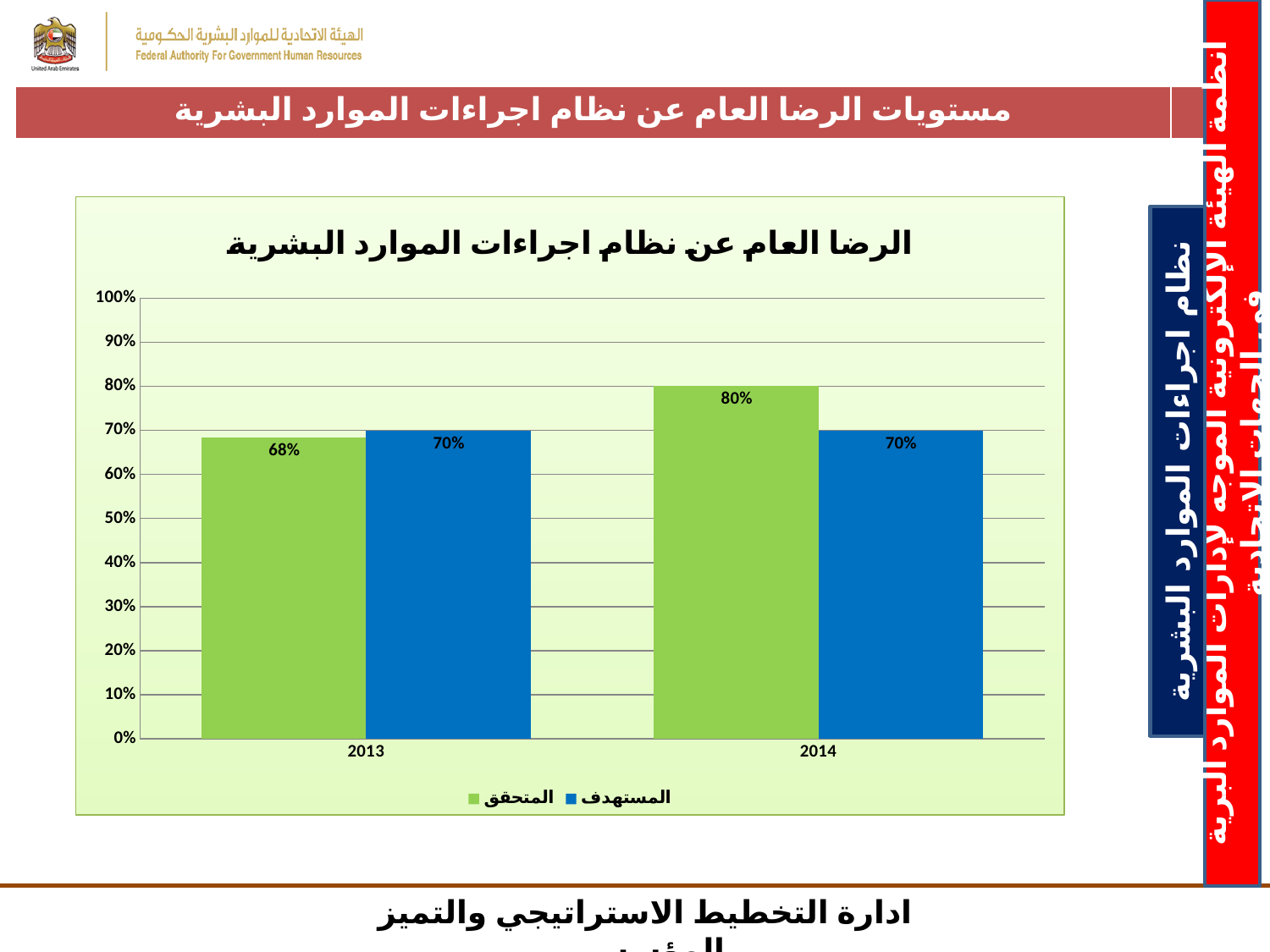
In 2013, which is larger: المتحقق (achieved) or المستهدف (target)? المستهدف (target) What is the value of المتحقق (achieved) for 2013? 68% In 2014, which is larger: المتحقق (achieved) or المستهدف (target)? المتحقق (achieved) Which year has the highest المتحقق (achieved) value? 2014 What is the value of المتحقق (achieved) for 2014? 80% What is the value of المستهدف (target) for 2014? 70% How many years are shown on the x axis? 2 In 2013, what is the difference between المستهدف (target) and المتحقق (achieved)? 2% What is the difference between the المتحقق (achieved) values for 2014 and 2013? 12% What kind of chart is shown? Bar chart How many series does the legend list? 2 Does the المتحقق (achieved) value rise or fall from 2013 to 2014? Rise